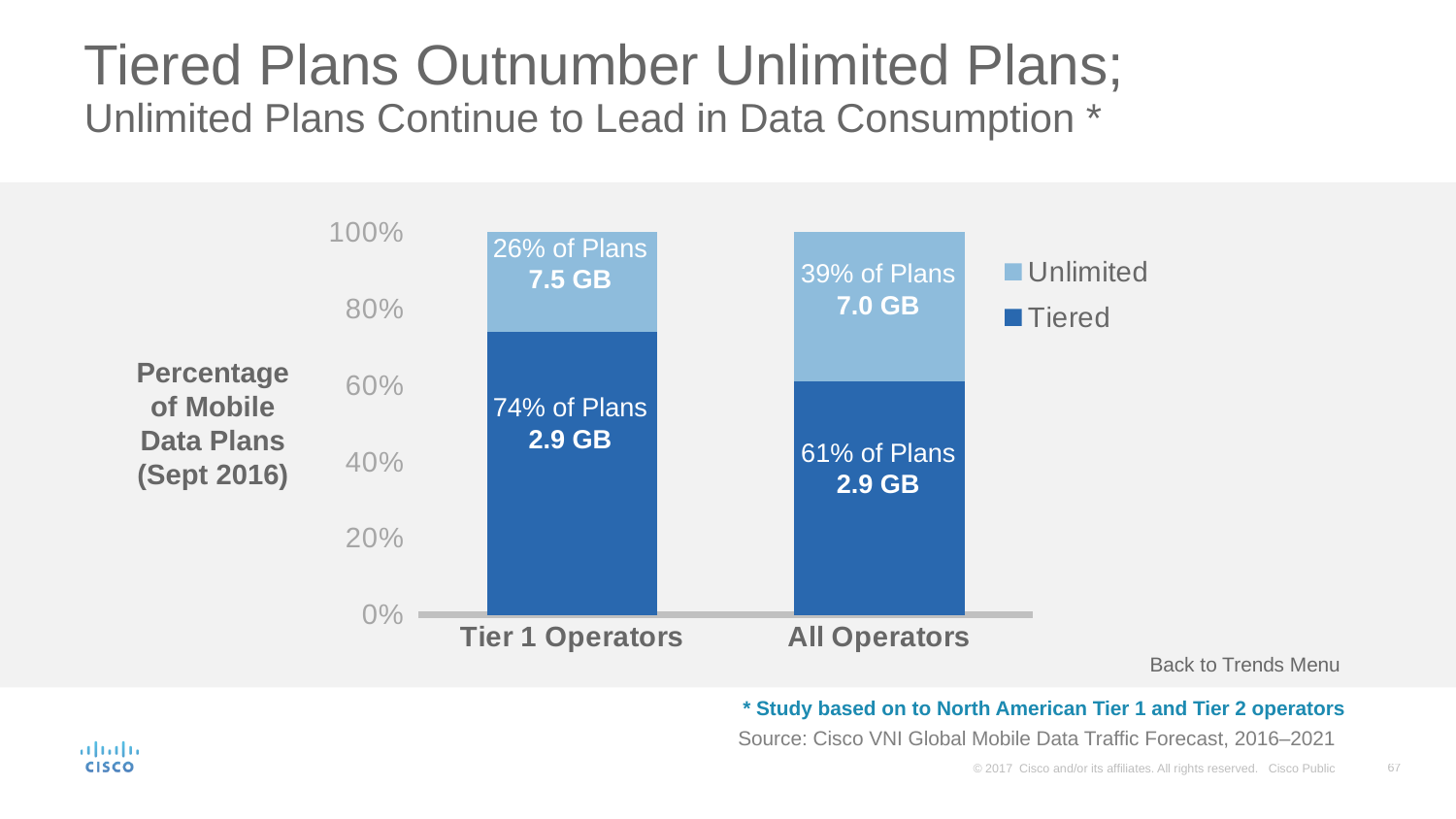
Which category has the larger Unlimited share of plans, Tier 1 Operators or All Operators? All Operators Which legend entry is shown in the darker blue colour? Tiered What is the total of the stacked bar for Tier 1 Operators? 100% How many categories are shown on the x axis? 2 Is the Tiered share of plans for Tier 1 Operators greater or less than 60%? greater How many series does the legend list? 2 What kind of chart is shown on the slide? Stacked bar chart What data consumption is shown for Unlimited plans for Tier 1 Operators? 7.5 GB What data consumption is shown for Tiered plans for All Operators? 2.9 GB What percentage of plans are Unlimited for All Operators? 39% What percentage of plans are Tiered for Tier 1 Operators? 74% What is the difference between the Tiered and Unlimited percentages of plans for All Operators? 22%